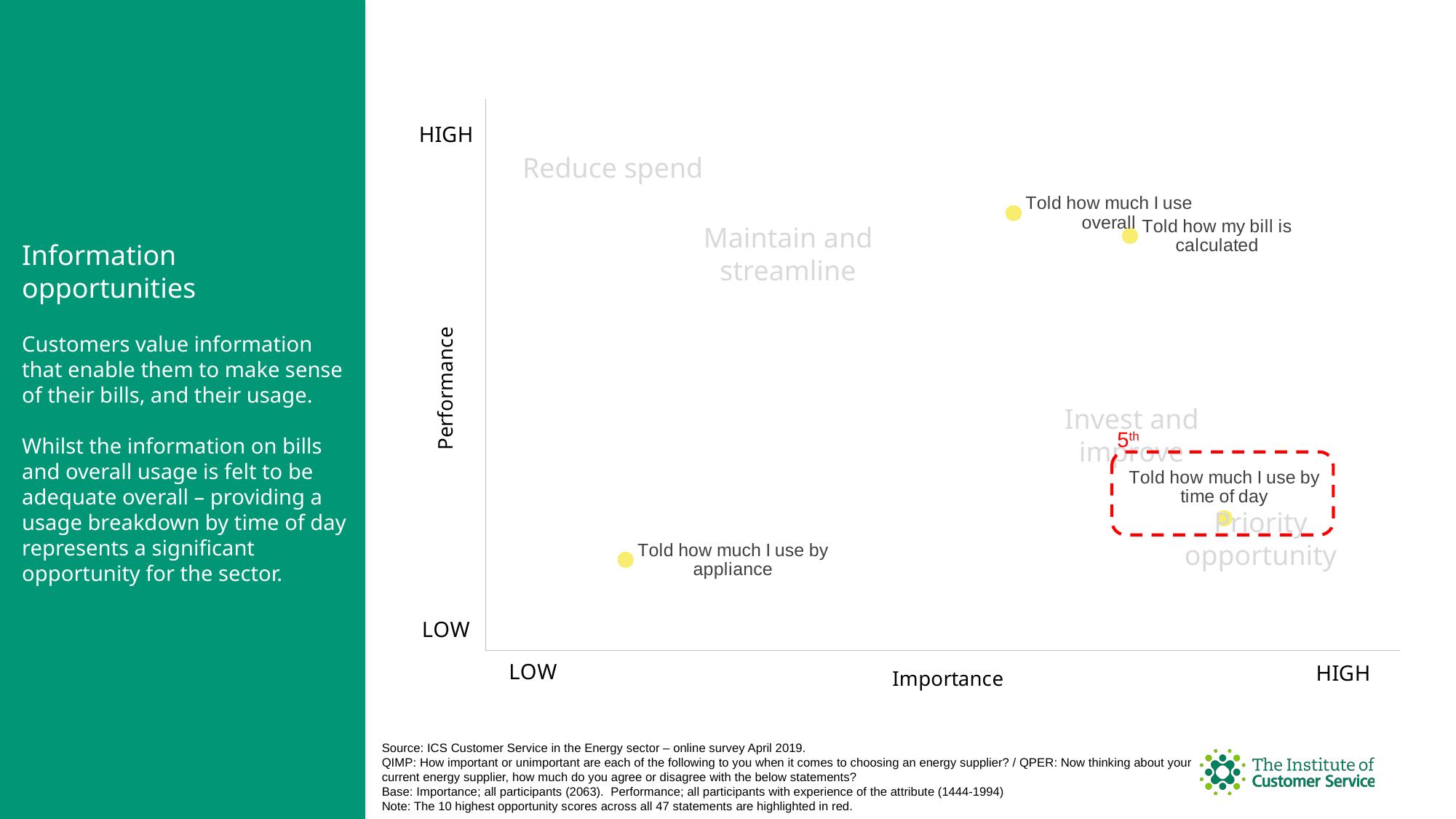
Which has higher Performance: 'Told how my bill is calculated' or 'Told how much I use by appliance'? Told how my bill is calculated How many data points are plotted on the chart? 4 What is the label of the vertical axis? Performance Which data point has the lowest Importance? Told how much I use by appliance What kind of chart is shown on the slide? Scatter chart What rank label is shown in red next to the highlighted data point? 5th Which has higher Importance: 'Told how much I use by appliance' or 'Told how much I use by time of day'? Told how much I use by time of day Which data point is highlighted with a red dashed box? Told how much I use by time of day Which has higher Performance: 'Told how much I use overall' or 'Told how much I use by time of day'? Told how much I use overall Which data point has the lowest Performance? Told how much I use by appliance Which data point has the highest Importance? Told how much I use by time of day What is the label of the horizontal axis? Importance